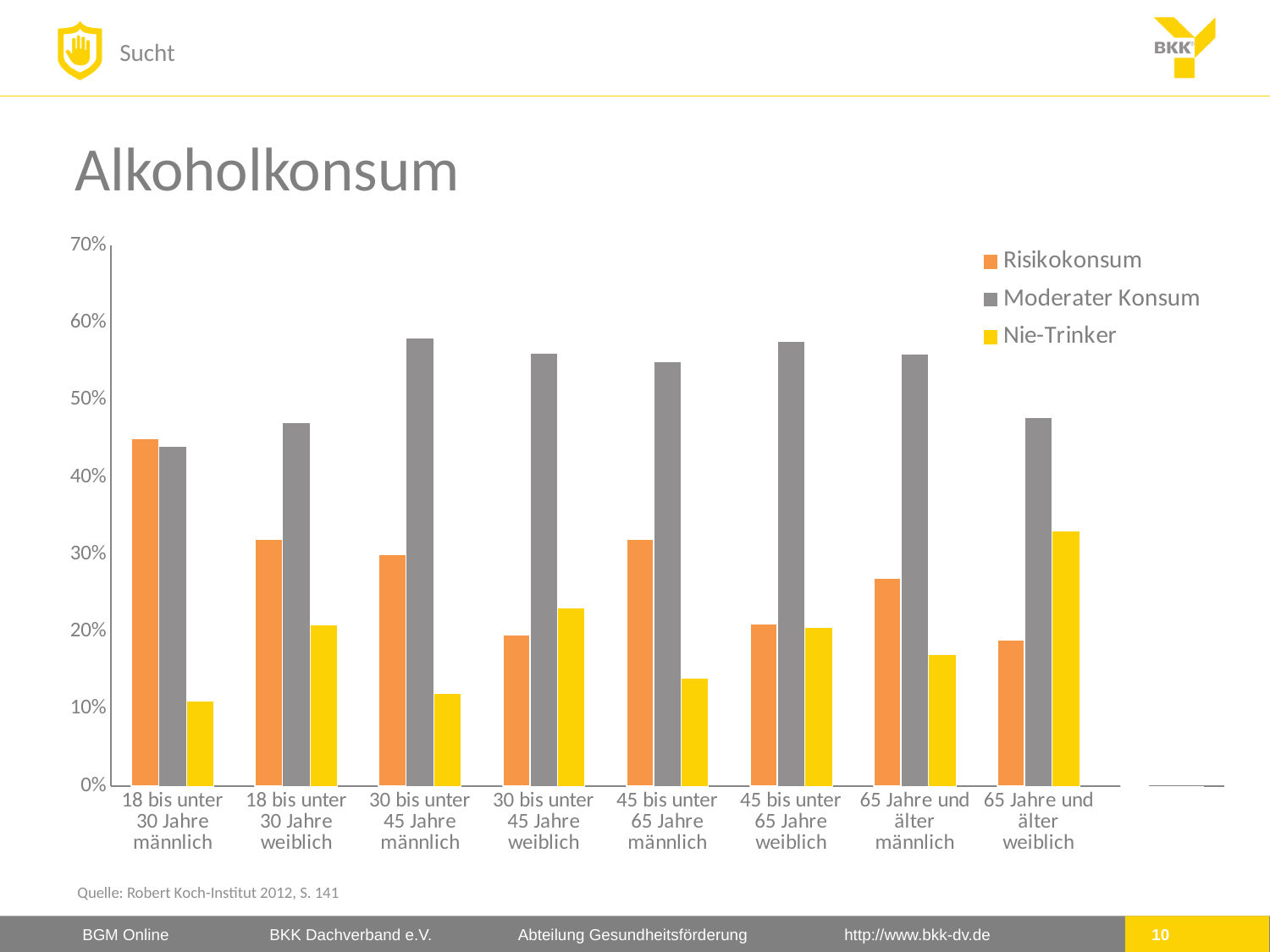
Which is larger for 18 bis unter 30 Jahre: the Risikokonsum value for männlich or for weiblich? männlich Which category has the highest Risikokonsum value? 18 bis unter 30 Jahre männlich How many series does the legend list? 3 How many age/gender categories are shown on the x axis? 8 Is the Moderater Konsum value for 30 bis unter 45 Jahre männlich greater or less than 50%? greater Is the Risikokonsum value for 18 bis unter 30 Jahre männlich greater or less than 40%? greater Is the Nie-Trinker value for 18 bis unter 30 Jahre männlich greater or less than 20%? less Which category has the highest Nie-Trinker value? 65 Jahre und älter weiblich What is the title of the chart? Alkoholkonsum What kind of chart is shown on the slide? bar chart